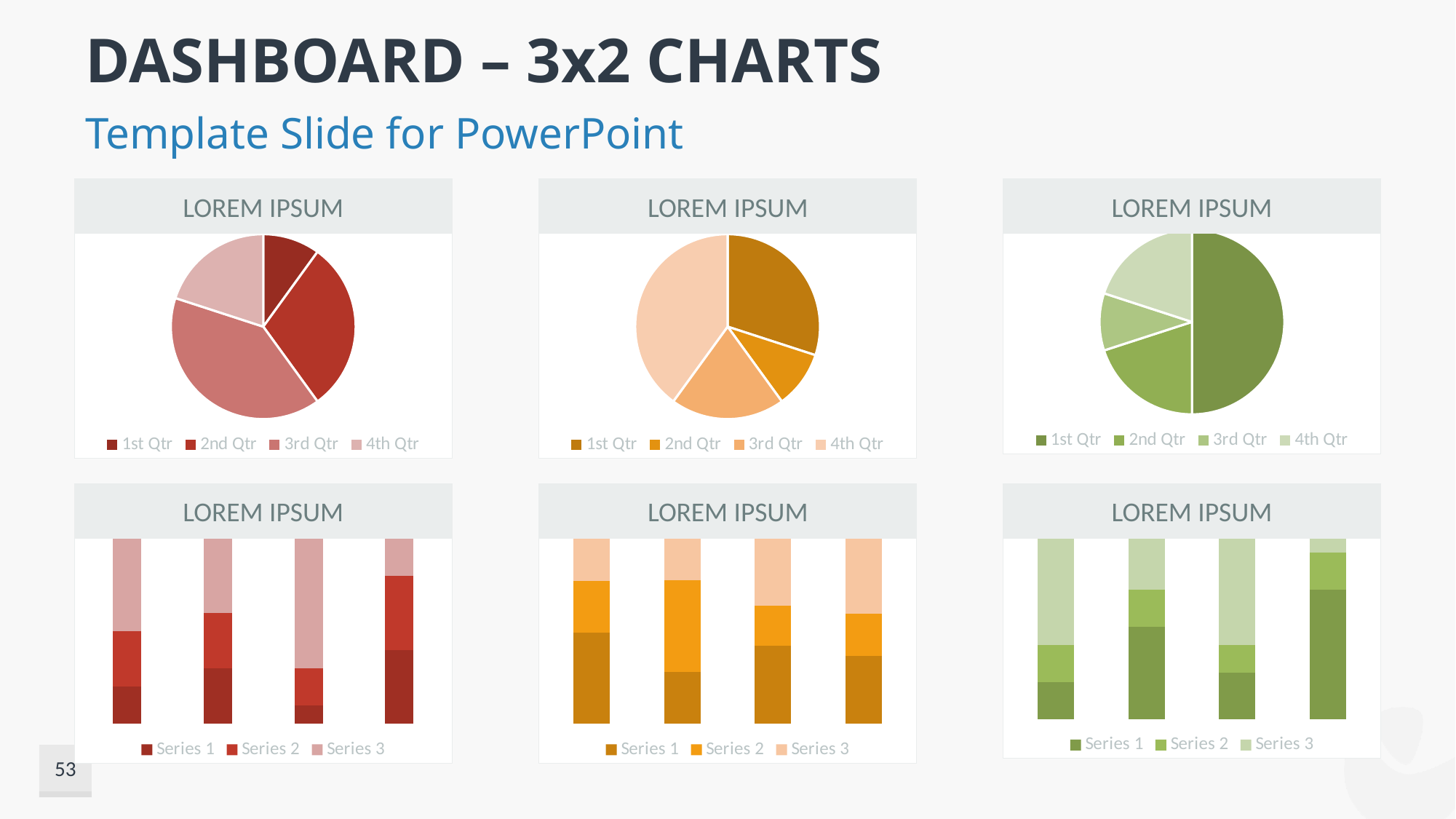
What kind of chart is the top-left chart on the slide? pie chart In the top-right pie chart, which slice is larger: 1st Qtr or 4th Qtr? 1st Qtr In the top-middle pie chart, which quarter has the largest slice? 4th Qtr How many categories does the legend of the top-middle pie chart list? 4 In the top-left pie chart, which quarter has the smallest slice? 1st Qtr In the top-left pie chart, which quarter has the largest slice? 3rd Qtr How many series does the legend of the bottom-left bar chart list? 3 In the top-middle pie chart, which quarter has the smallest slice? 2nd Qtr How many bars are plotted in the bottom-right bar chart? 4 What kind of chart is the bottom-middle chart on the slide? bar chart What is the title shown above the bottom-right chart? LOREM IPSUM In the top-right pie chart, which quarter has the largest slice? 1st Qtr